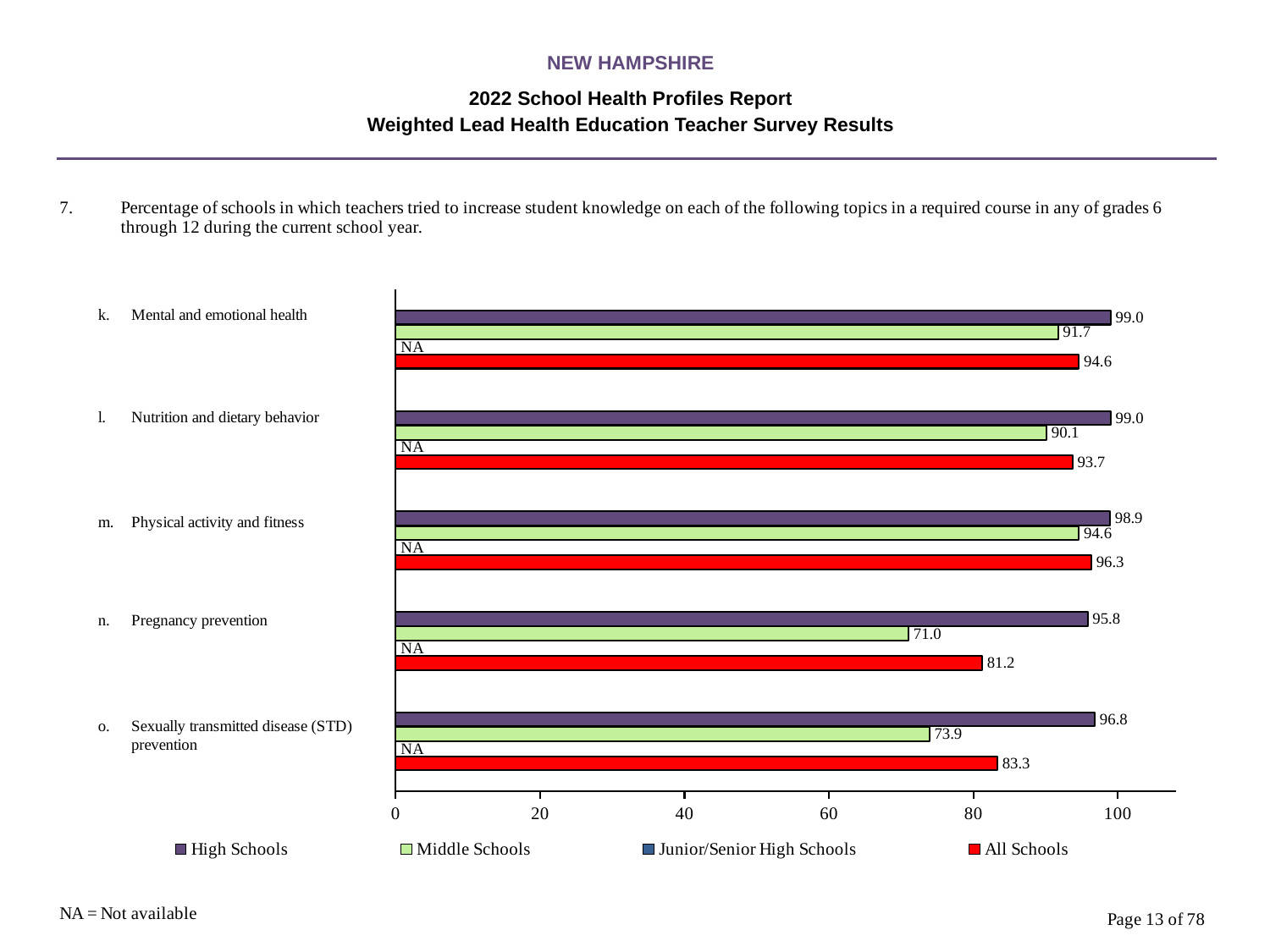
What is the Middle Schools value for Pregnancy prevention? 71.0 What is the difference between the High Schools and Middle Schools values for Pregnancy prevention? 24.8 What is the All Schools value for Sexually transmitted disease (STD) prevention? 83.3 Which topic has the lowest Middle Schools value? Pregnancy prevention Which topic has the highest All Schools value? Physical activity and fitness What value is shown for Junior/Senior High Schools for each topic? NA What is the High Schools value for Mental and emotional health? 99.0 Which is larger for Physical activity and fitness: the Middle Schools value or the All Schools value? All Schools How many topics are shown on the chart? 5 How many series does the legend list? 4 What is the Middle Schools value for Nutrition and dietary behavior? 90.1 What kind of chart is shown on the slide? Bar chart